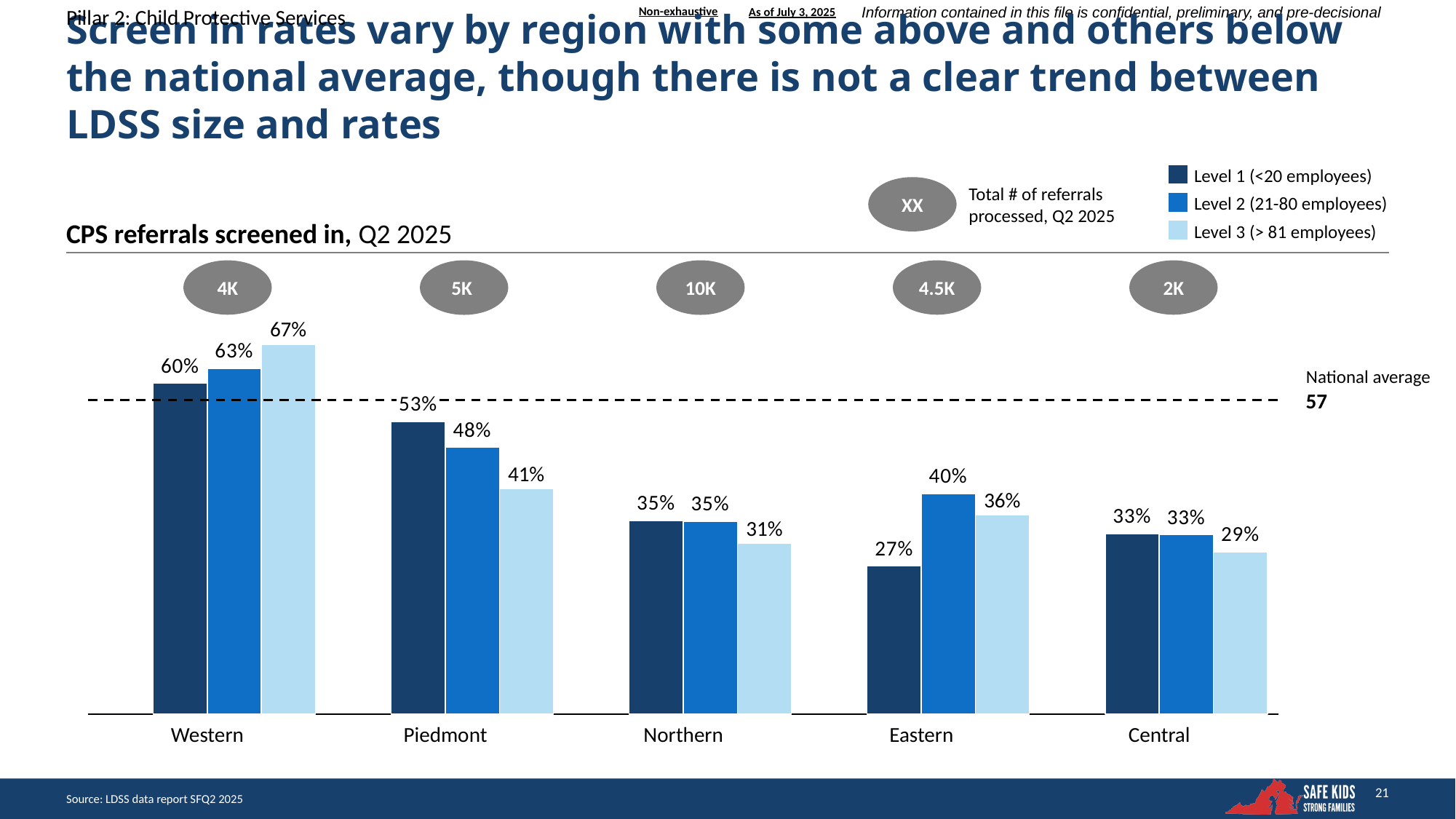
What is the total number of referrals processed shown for the Northern region? 10K Which region has the highest Level 1 (<20 employees) screen-in rate? Western What is the difference between the Level 3 and Level 1 screen-in rates in the Piedmont region? 12% What is the Level 3 (> 81 employees) screen-in rate for the Western region? 67% Which is larger: the Level 2 rate for Eastern or the Level 2 rate for Central? Eastern Which region has the lowest Level 3 (> 81 employees) screen-in rate? Central What is the national average screen-in rate shown by the dashed line? 57 What kind of chart is shown on the slide? Bar chart What is the Level 1 (<20 employees) screen-in rate for the Eastern region? 27% What is the Level 2 (21-80 employees) screen-in rate for the Piedmont region? 48% How many series does the legend list? 3 How many regions are shown on the x axis of the chart? 5